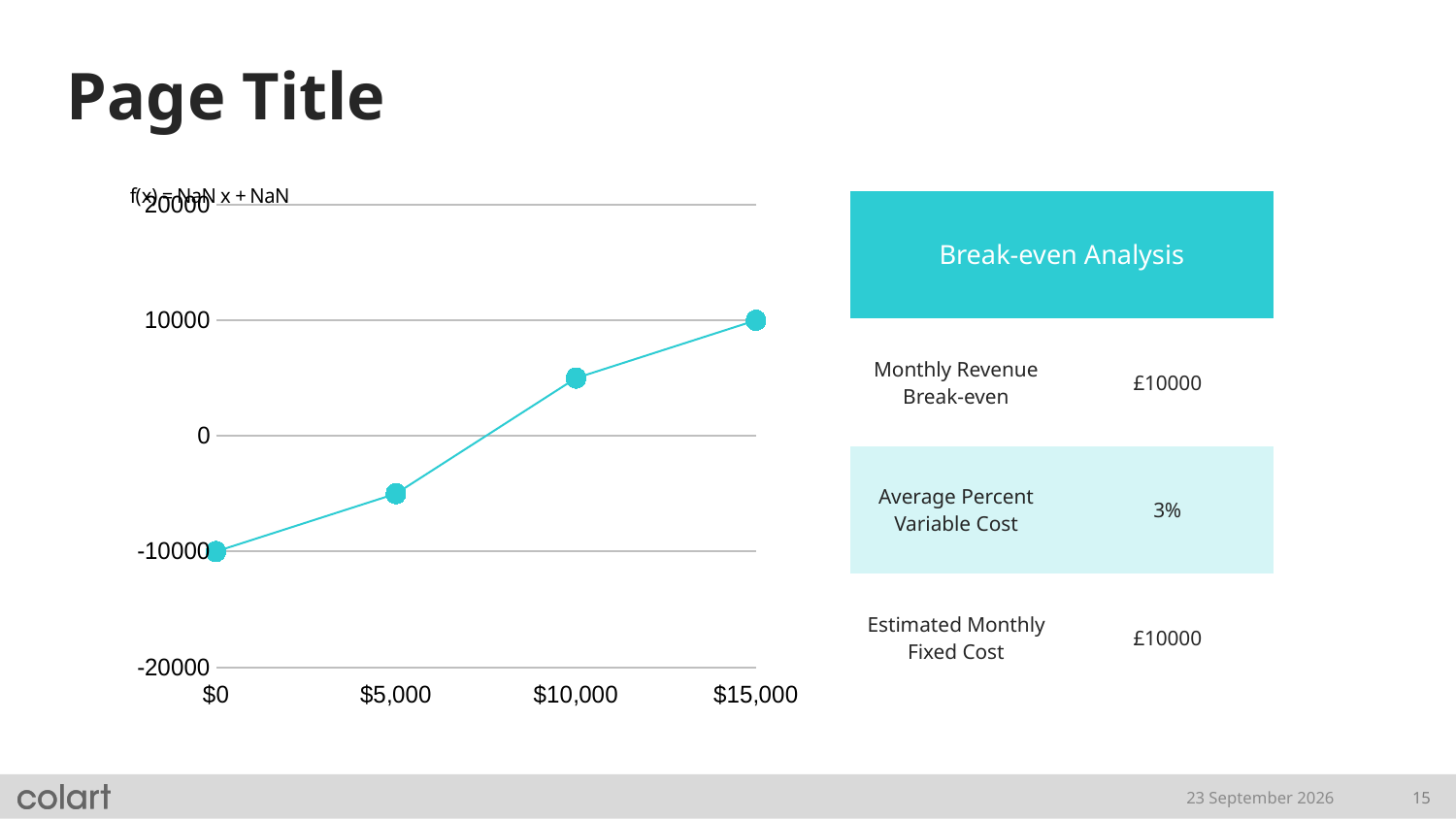
At which x-axis value is the plotted value lowest? $0 Is the value at $10,000 greater or less than 0? greater How many data points are plotted on the line? 4 At which x-axis value is the plotted value highest? $15,000 What is the difference between the plotted value at $15,000 and the plotted value at $0? 20000 Is the value at $10,000 greater or less than 10000? less Do the plotted values rise or fall as the x axis goes from $0 to $15,000? rise Is the value at $5,000 greater or less than 0? less What is the plotted value at $0 on the x axis? -10000 What is the plotted value at $15,000 on the x axis? 10000 Which has the larger plotted value, $5,000 or $10,000? $10,000 What kind of chart is shown on the slide? line chart